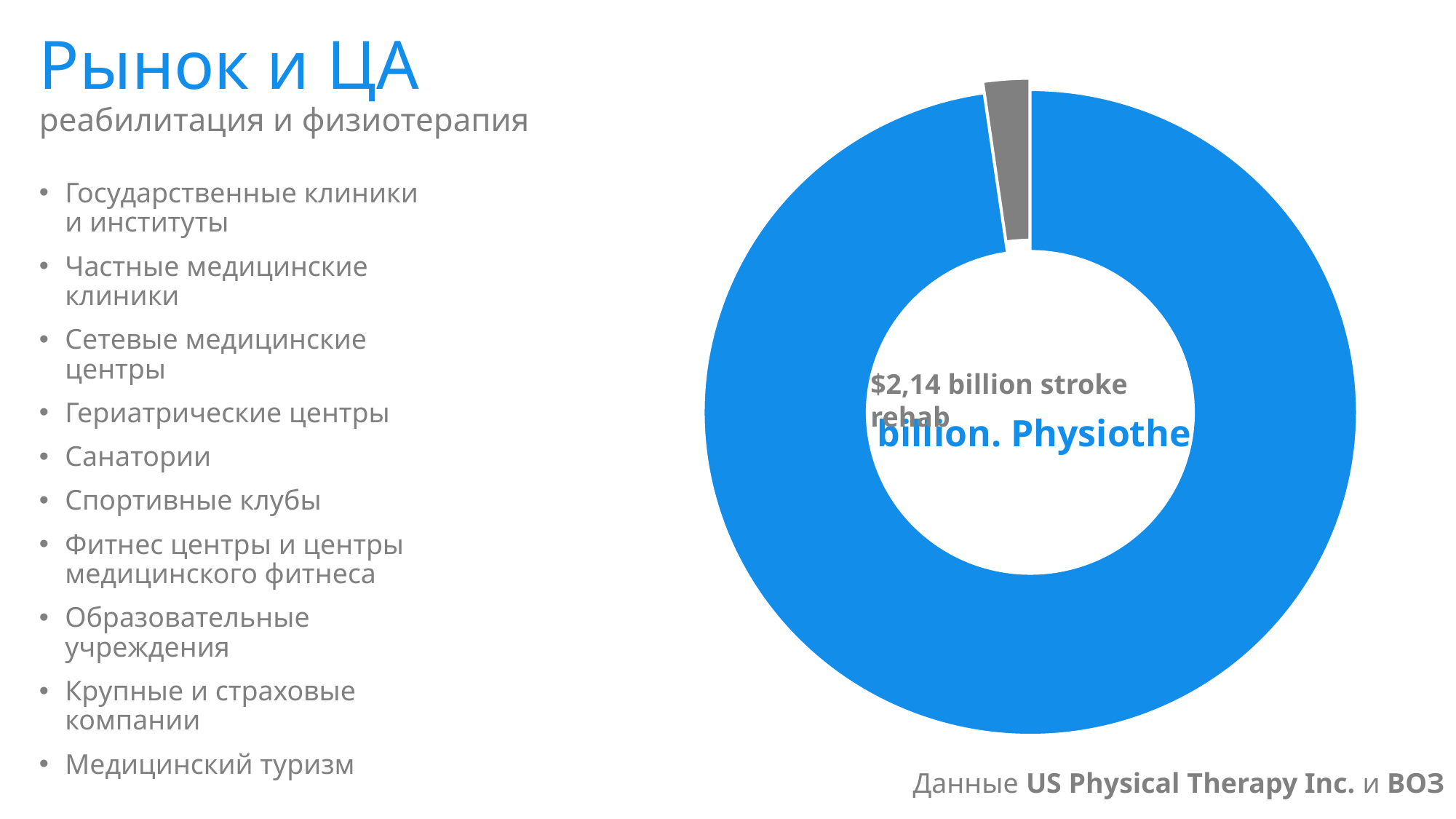
How many slices does the donut chart contain? 2 What kind of chart is shown on the right side of the slide? Pie (donut) chart Is the blue slice of the donut chart greater or less than 50% of the whole? greater Is the gray slice of the donut chart greater or less than 50% of the whole? less According to the note under the chart, whose data is the chart based on? US Physical Therapy Inc. и ВОЗ Which slice of the donut chart is larger, the blue one or the gray one? The blue one What dollar figure is printed in the centre of the donut chart? $2,14 billion stroke rehab